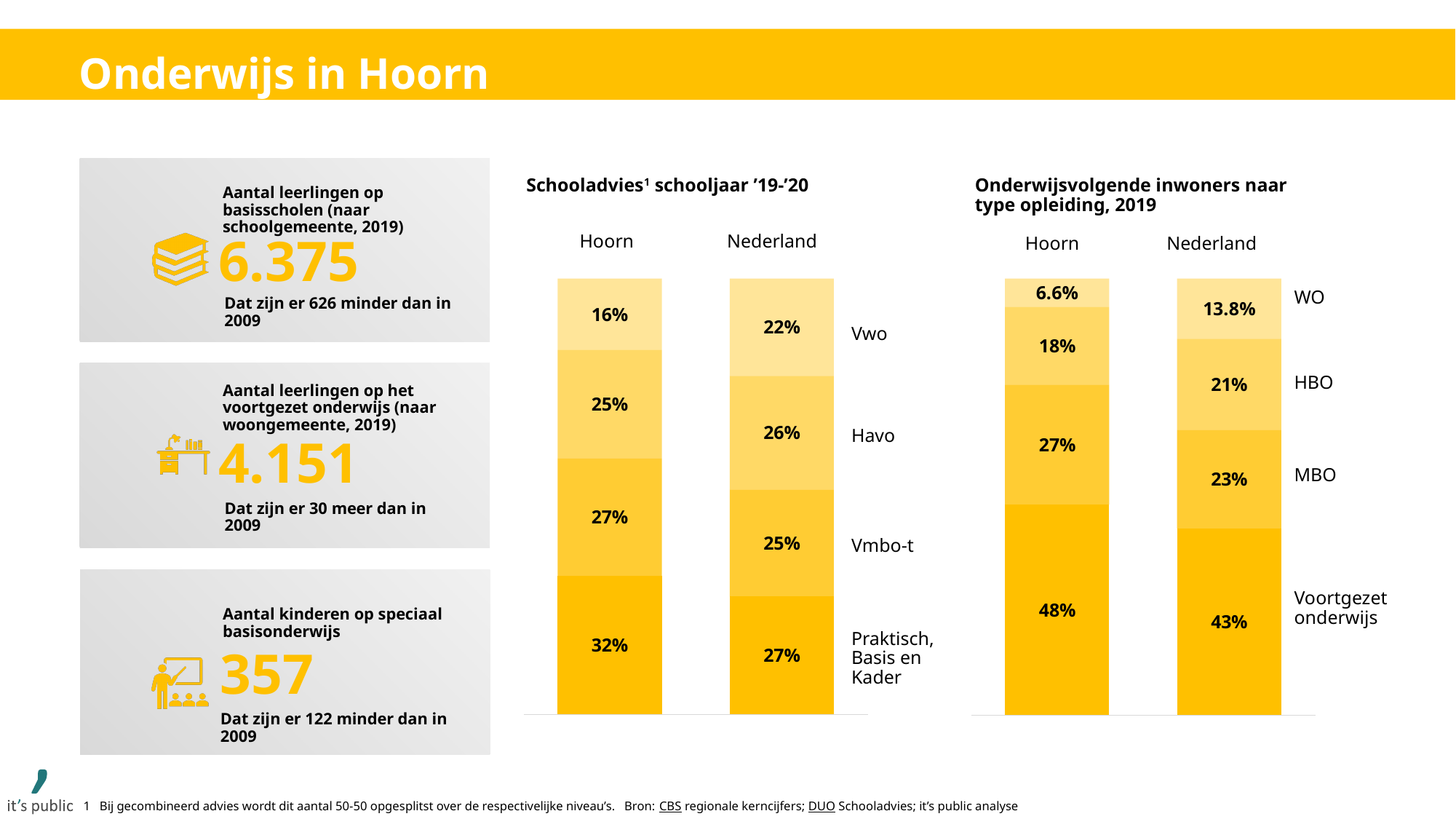
In the 'Schooladvies schooljaar '19-'20' chart, which segment of the Hoorn bar is the smallest? Vwo In the 'Schooladvies schooljaar '19-'20' chart, what percentage of the Nederland bar is Havo? 26% In the 'Schooladvies schooljaar '19-'20' chart, is the Vmbo-t share larger for Hoorn or for Nederland? Hoorn In the 'Onderwijsvolgende inwoners naar type opleiding, 2019' chart, is the HBO share larger for Hoorn or for Nederland? Nederland What type of chart is the 'Onderwijsvolgende inwoners naar type opleiding, 2019' chart? Stacked bar chart In the 'Schooladvies schooljaar '19-'20' chart, what percentage of the Hoorn bar is Praktisch, Basis en Kader? 32% In the 'Onderwijsvolgende inwoners naar type opleiding, 2019' chart, what percentage of the Nederland bar is MBO? 23% In the 'Schooladvies schooljaar '19-'20' chart, which segment of the Nederland bar is the largest? Praktisch, Basis en Kader In the 'Schooladvies schooljaar '19-'20' chart, what is the difference between the Vwo share for Nederland and for Hoorn? 6 percentage points In the 'Schooladvies schooljaar '19-'20' chart, what percentage of the Hoorn bar is Vwo? 16% In the 'Onderwijsvolgende inwoners naar type opleiding, 2019' chart, what is the difference between the Voortgezet onderwijs share for Hoorn and for Nederland? 5 percentage points In the 'Onderwijsvolgende inwoners naar type opleiding, 2019' chart, what percentage of the Hoorn bar is WO? 6.6%